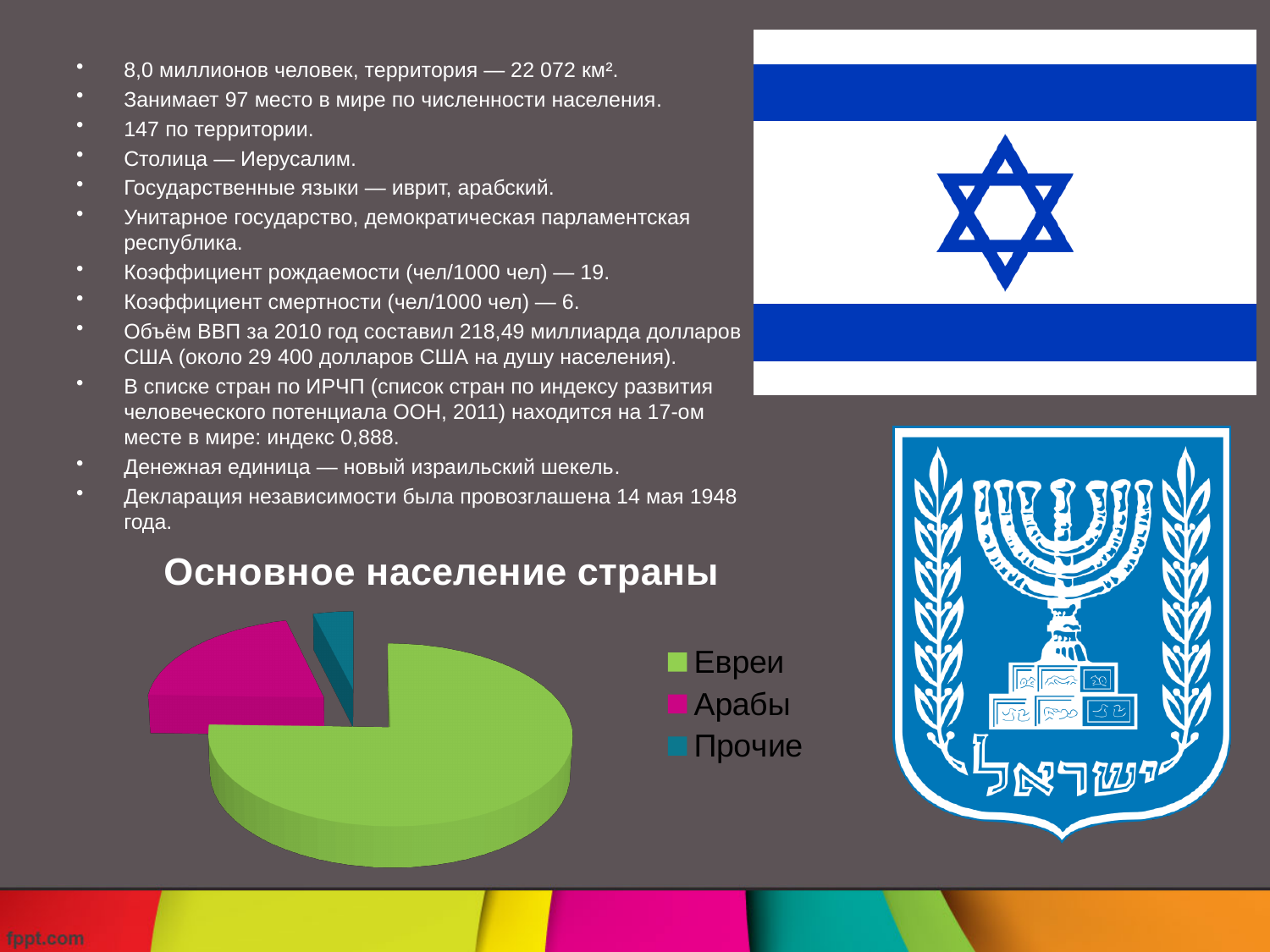
How many entries does the legend of the pie chart list? 3 How many slices does the pie chart "Основное население страны" have? 3 In the pie chart, which slice is larger: Евреи or Арабы? Евреи What kind of chart is shown under the heading "Основное население страны"? pie chart What is the title of the pie chart on the slide? Основное население страны What colour is the slice for Евреи in the pie chart? green In the pie chart, which slice is larger: Арабы or Прочие? Арабы Which category has the smallest slice in the pie chart "Основное население страны"? Прочие Which category has the largest slice in the pie chart "Основное население страны"? Евреи